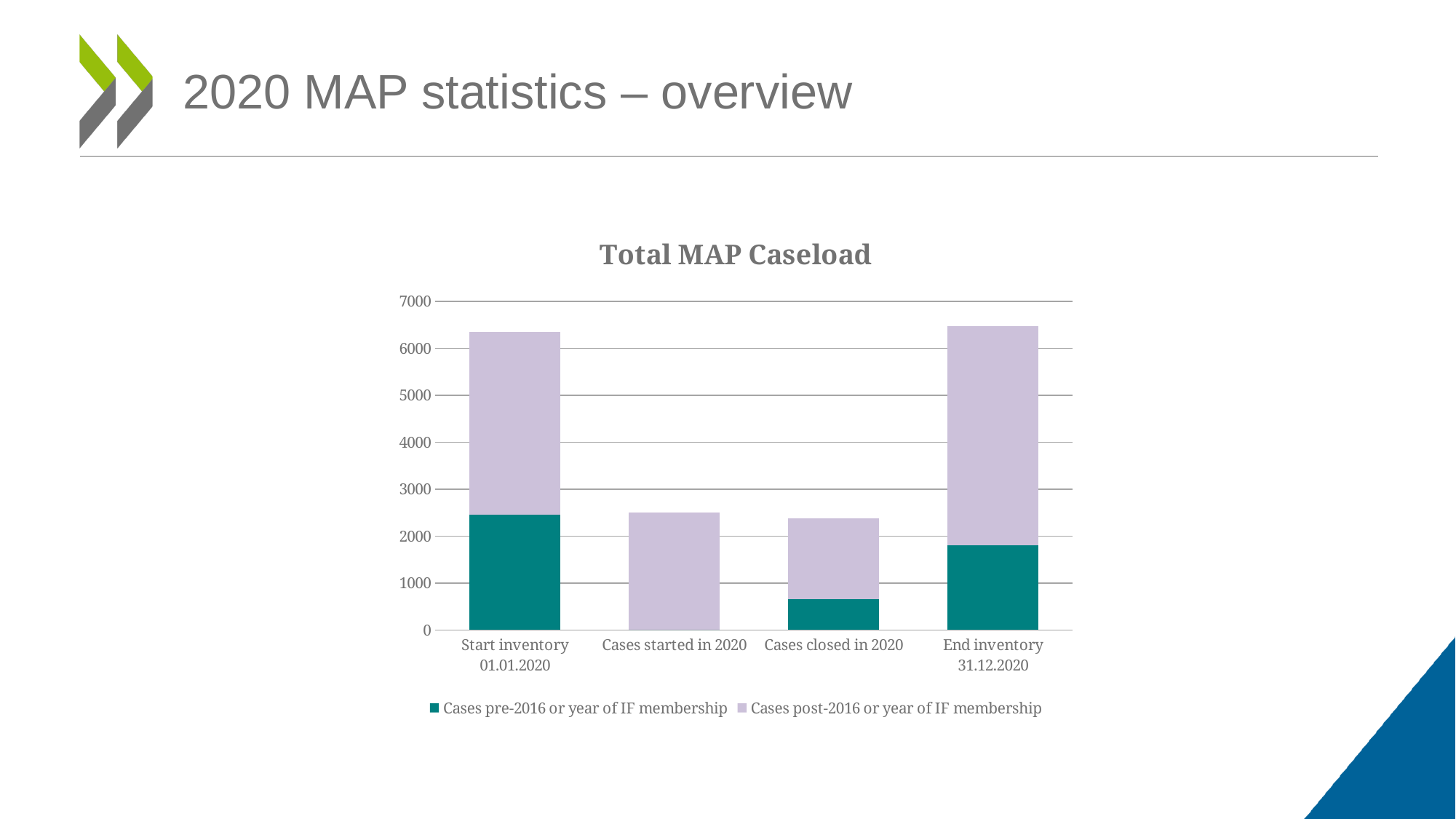
Which series is shown in teal in the chart? Cases pre-2016 or year of IF membership Which has the larger Cases pre-2016 or year of IF membership value: Start inventory 01.01.2020 or End inventory 31.12.2020? Start inventory 01.01.2020 How many series does the chart's legend list? 2 Is the Cases pre-2016 or year of IF membership value for Cases closed in 2020 greater or less than 1000? less Is the total value for Cases closed in 2020 greater or less than 3000? less Is the total value for Start inventory 01.01.2020 greater or less than 6000? greater What kind of chart is shown on the slide? bar chart How many categories are shown on the x axis of the chart? 4 What is the title of the chart? Total MAP Caseload Which has the larger Cases post-2016 or year of IF membership value: Start inventory 01.01.2020 or End inventory 31.12.2020? End inventory 31.12.2020